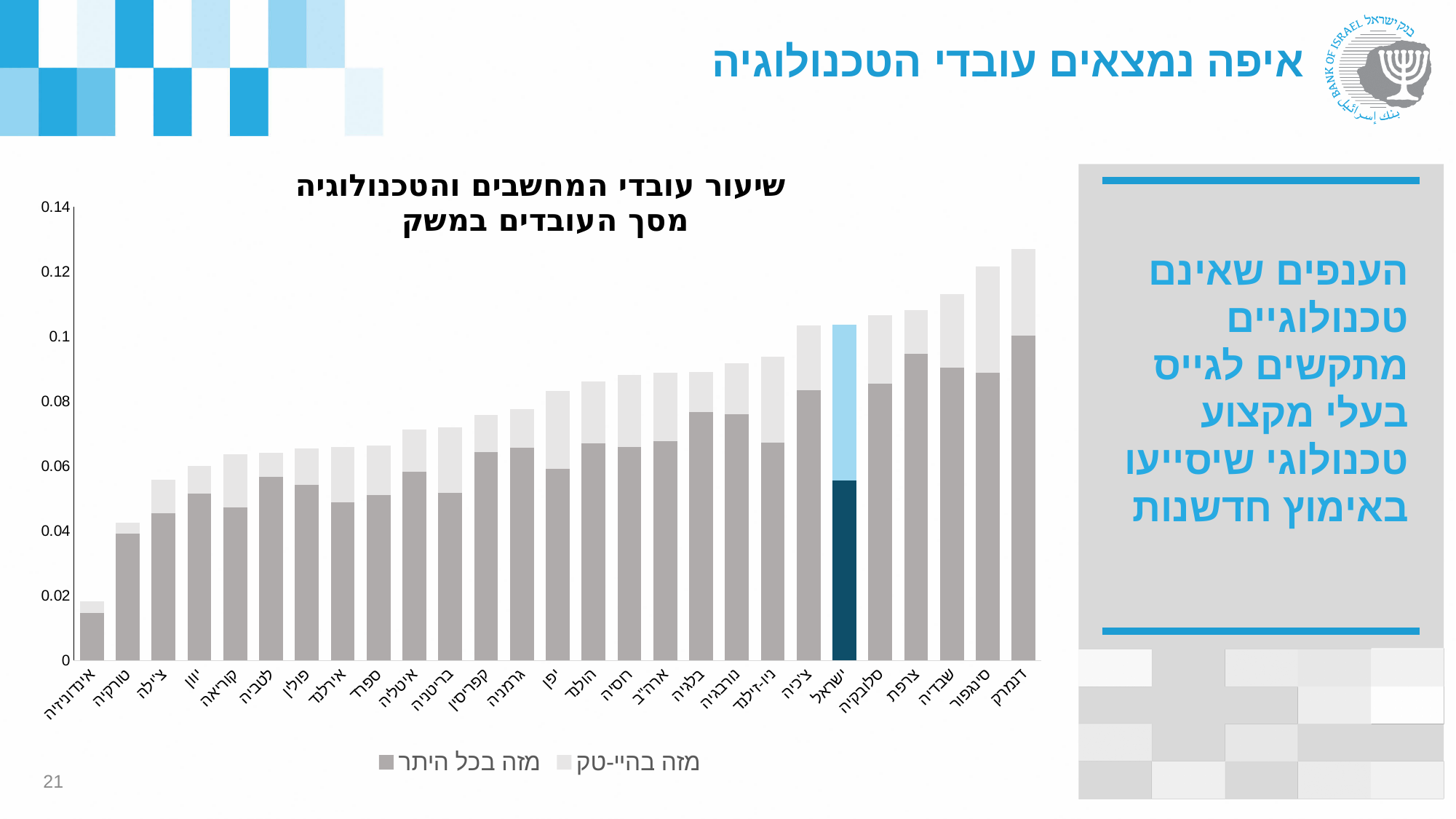
Which country has the lowest total bar? אינדוניזיה How many series does the legend list? 2 Do the total bar values rise or fall from left to right along the x axis? rise Which country's bar is highlighted in blue instead of grey? ישראל Which country has the highest total bar? דנמרק Which has a larger total bar, דנמרק or אינדונזיה? דנמרק Is the total value for דנמרק greater or less than 0.12? greater What kind of chart is shown on the slide? bar chart Is the total value for שבדיה greater or less than 0.1? greater How many countries are shown on the x axis? 27 Is the total value for ישראל greater or less than 0.1? greater